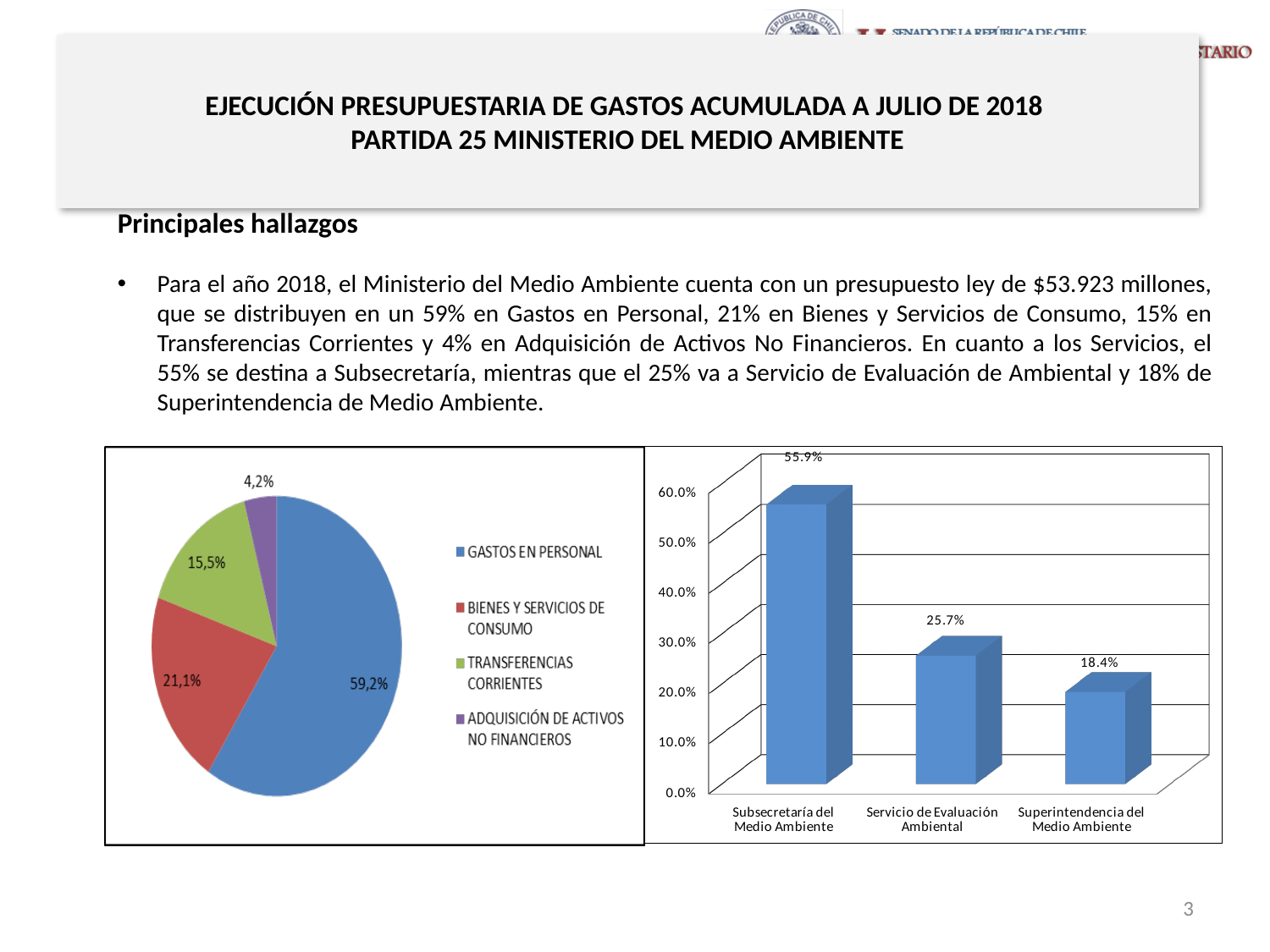
On the bar chart on the right, what is the value for Superintendencia del Medio Ambiente? 18.4% On the pie chart on the left, what is the difference between the shares of BIENES Y SERVICIOS DE CONSUMO and TRANSFERENCIAS CORRIENTES? 5,6% On the bar chart on the right, what is the value for Servicio de Evaluación Ambiental? 25.7% On the pie chart on the left, what share does GASTOS EN PERSONAL have? 59,2% What kind of chart is the chart on the right? Bar chart On the bar chart on the right, what is the difference between Subsecretaría del Medio Ambiente and Servicio de Evaluación Ambiental? 30.2% On the bar chart on the right, do the values rise or fall from left to right? Fall On the pie chart on the left, which category has the smallest slice? ADQUISICIÓN DE ACTIVOS NO FINANCIEROS On the pie chart on the left, what share does TRANSFERENCIAS CORRIENTES have? 15,5% On the pie chart on the left, which category has the largest slice? GASTOS EN PERSONAL On the pie chart on the left, how many categories does the legend list? 4 On the bar chart on the right, which category has the highest value? Subsecretaría del Medio Ambiente